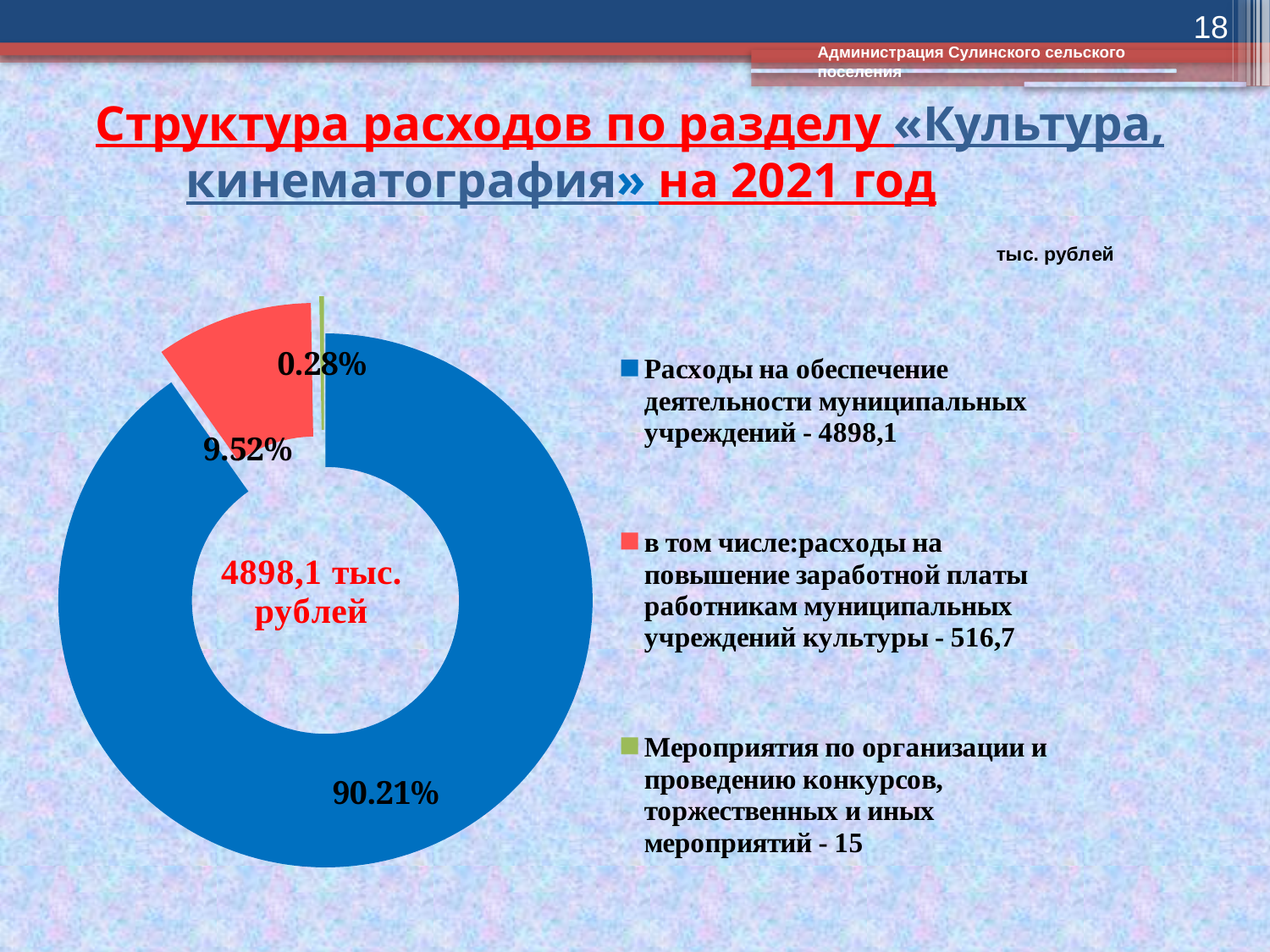
Which category has the largest slice of the pie? Расходы на обеспечение деятельности муниципальных учреждений How many slices does the pie chart have? 3 What value (in тыс. рублей) is given in the legend for "Мероприятия по организации и проведению конкурсов, торжественных и иных мероприятий"? 15 What value (in тыс. рублей) is given in the legend for "Расходы на обеспечение деятельности муниципальных учреждений"? 4898,1 What value (in тыс. рублей) is given in the legend for "расходы на повышение заработной платы работникам муниципальных учреждений культуры"? 516,7 What share of the pie does the slice for "Расходы на обеспечение деятельности муниципальных учреждений" represent? 90.21% What text is printed in the centre of the doughnut chart? 4898,1 тыс. рублей What kind of chart is shown on the slide? doughnut (pie) chart What share of the pie does the slice for "в том числе: расходы на повышение заработной платы работникам муниципальных учреждений культуры" represent? 9.52% What is the difference in percentage points between the 90.21% slice and the 9.52% slice? 80.69% What share of the pie does the slice for "Мероприятия по организации и проведению конкурсов, торжественных и иных мероприятий" represent? 0.28% Which category has the smallest slice of the pie? Мероприятия по организации и проведению конкурсов, торжественных и иных мероприятий